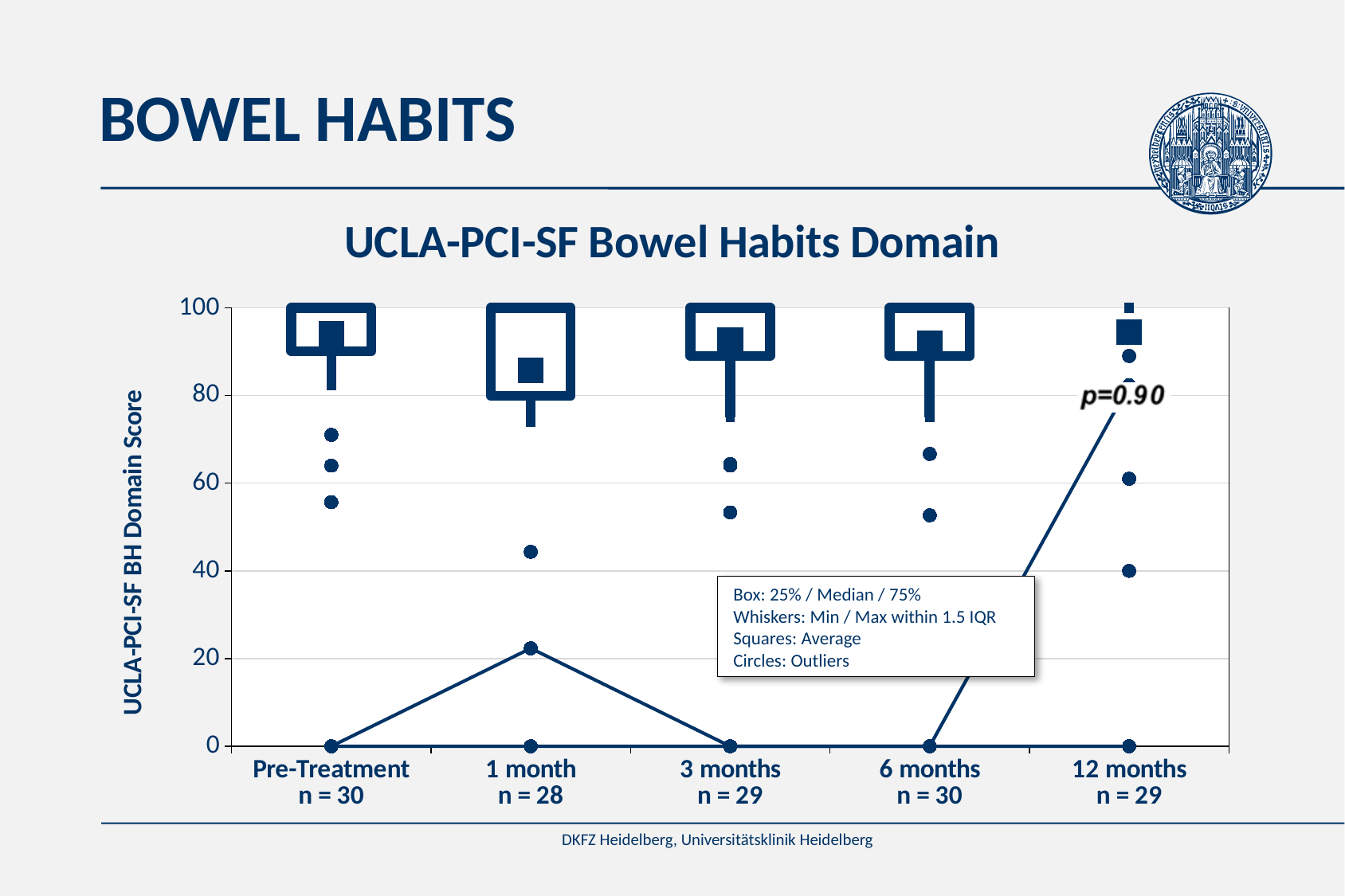
What is the title of the chart? UCLA-PCI-SF Bowel Habits Domain What is the sample size (n) at the 12 months time point? n = 29 What p-value is printed on the chart? p=0.90 What kind of chart is shown on the slide? Box plot What is the sample size (n) at the 1 month time point? n = 28 Which time point has the lowest average (square) score? 1 month Is the average (square) at Pre-Treatment greater or less than 90? greater What is the sample size (n) at the Pre-Treatment time point? n = 30 According to the legend box, what do the circles on the chart represent? Outliers Is the average (square) at 1 month greater or less than 90? less Is the lowest non-zero outlier at 12 months greater or less than 60? less How many time points are shown on the x axis of the chart? 5